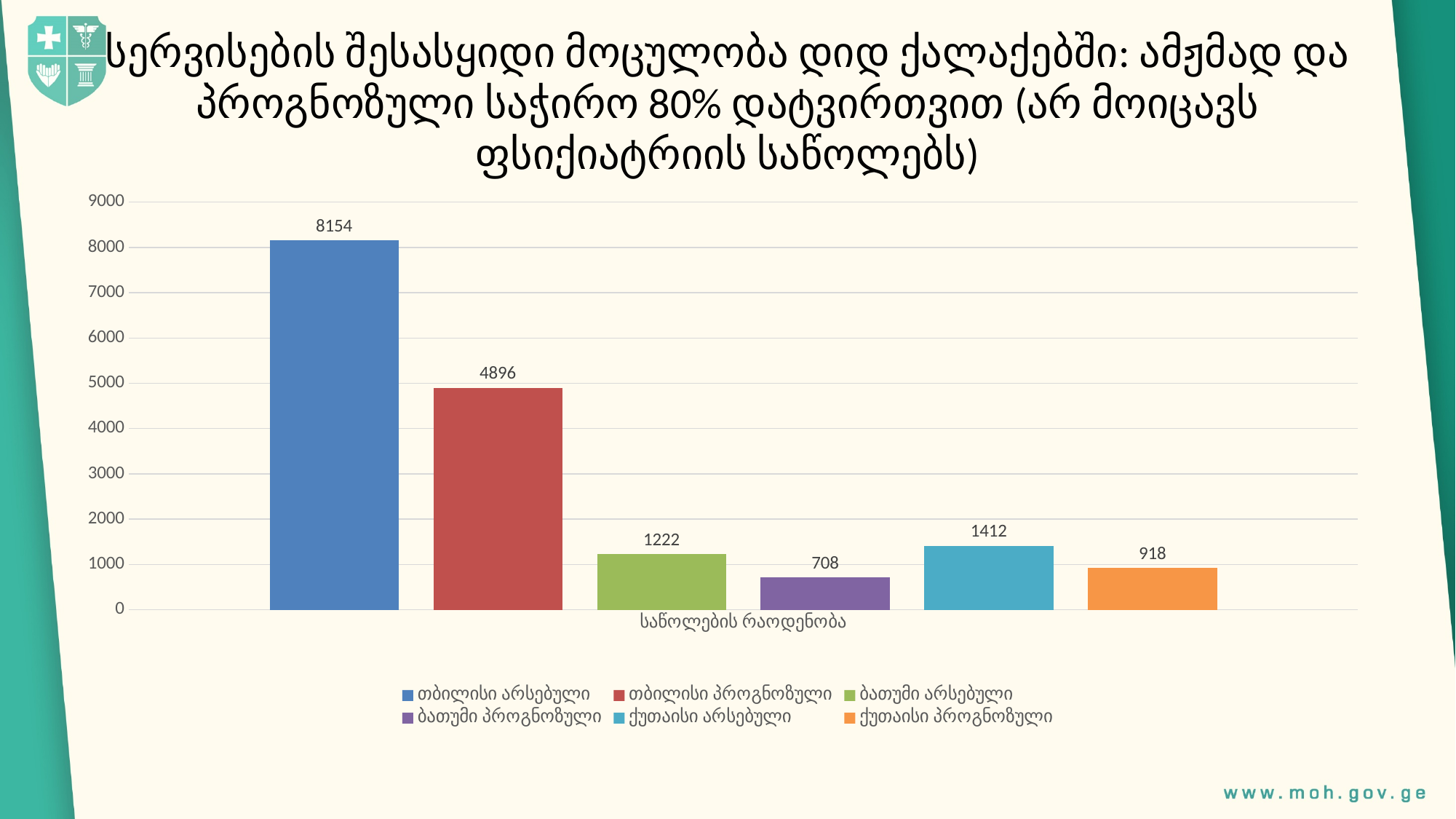
What is the value for the series "ბათუმი არსებული"? 1222 What kind of chart is shown on the slide? Bar chart What is the value for the series "თბილისი პროგნოზული"? 4896 Which series has the lowest value? ბათუმი პროგნოზული Which series has the highest value? თბილისი არსებული What is the difference between the values for "ქუთაისი არსებული" and "ქუთაისი პროგნოზული"? 494 How many series does the legend list? 6 What is the value for the series "თბილისი არსებული"? 8154 What is the label on the x axis under the bars? საწოლების რაოდენობა What is the difference between the values for "თბილისი არსებული" and "თბილისი პროგნოზული"? 3258 Which is larger, the value for "ბათუმი არსებული" or the value for "ქუთაისი არსებული"? ქუთაისი არსებული What is the value for the series "ქუთაისი პროგნოზული"? 918